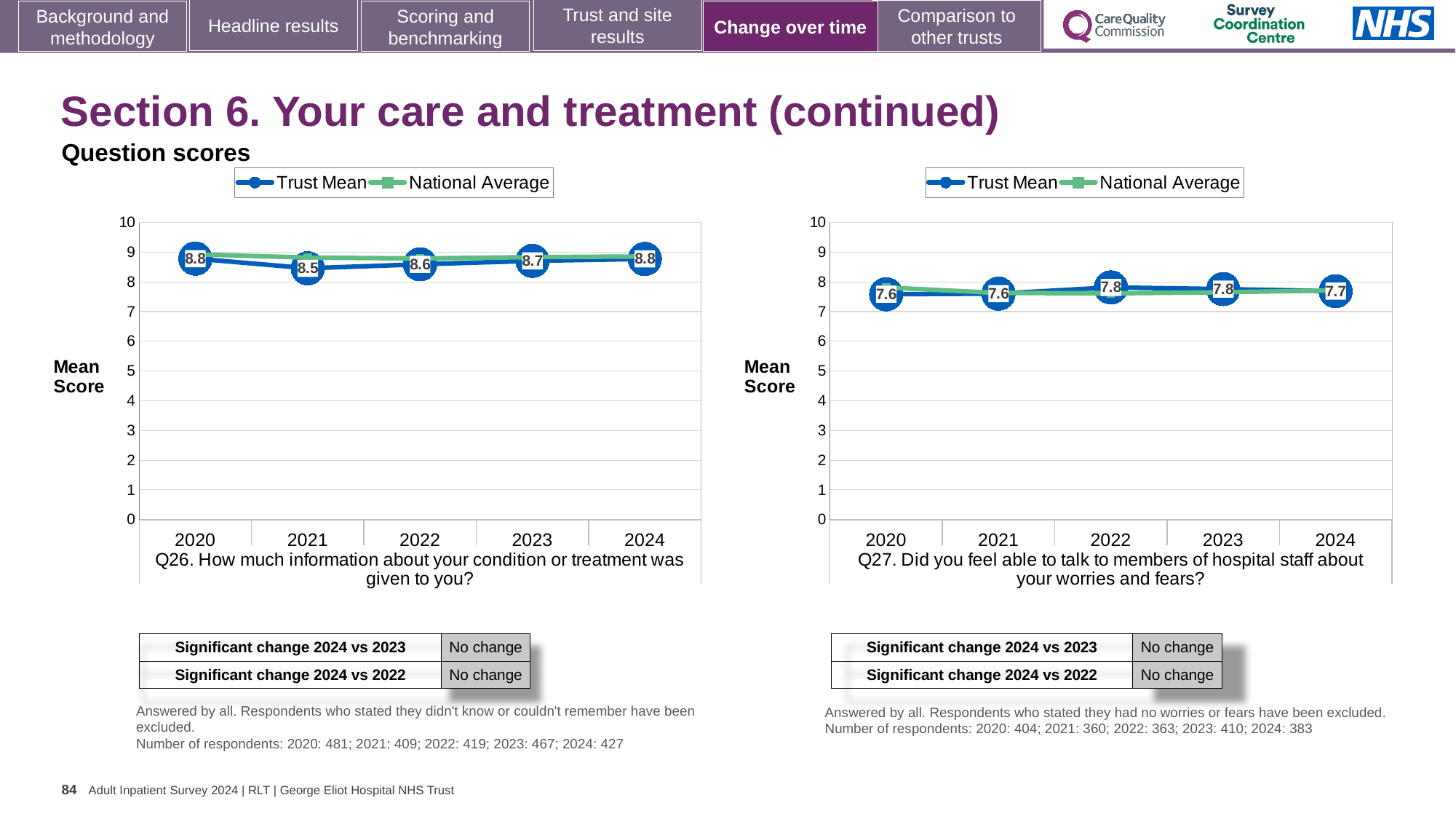
In the Q27 chart on the right, what is the Trust Mean score for 2022? 7.8 In the Q26 chart on the left, does the Trust Mean score rise or fall from 2021 to 2024? Rise In the Q27 chart on the right, is the Trust Mean score higher in 2020 or in 2022? 2022 In the Q27 chart on the right, what is the Trust Mean score for 2024? 7.7 In the Q26 chart on the left, what is the Trust Mean score for 2024? 8.8 How many years are plotted on the x axis of the Q27 chart on the right? 5 What type of chart is the Q27 chart on the right? Line chart How many series does the legend of the Q26 chart on the left list? 2 In the Q26 chart on the left, what is the difference between the Trust Mean scores for 2024 and 2021? 0.3 In the Q26 chart on the left, what is the Trust Mean score for 2021? 8.5 In the Q26 chart on the left, which year has the lowest Trust Mean score? 2021 In the Q26 chart on the left, is the National Average value for 2020 greater or less than 8? greater